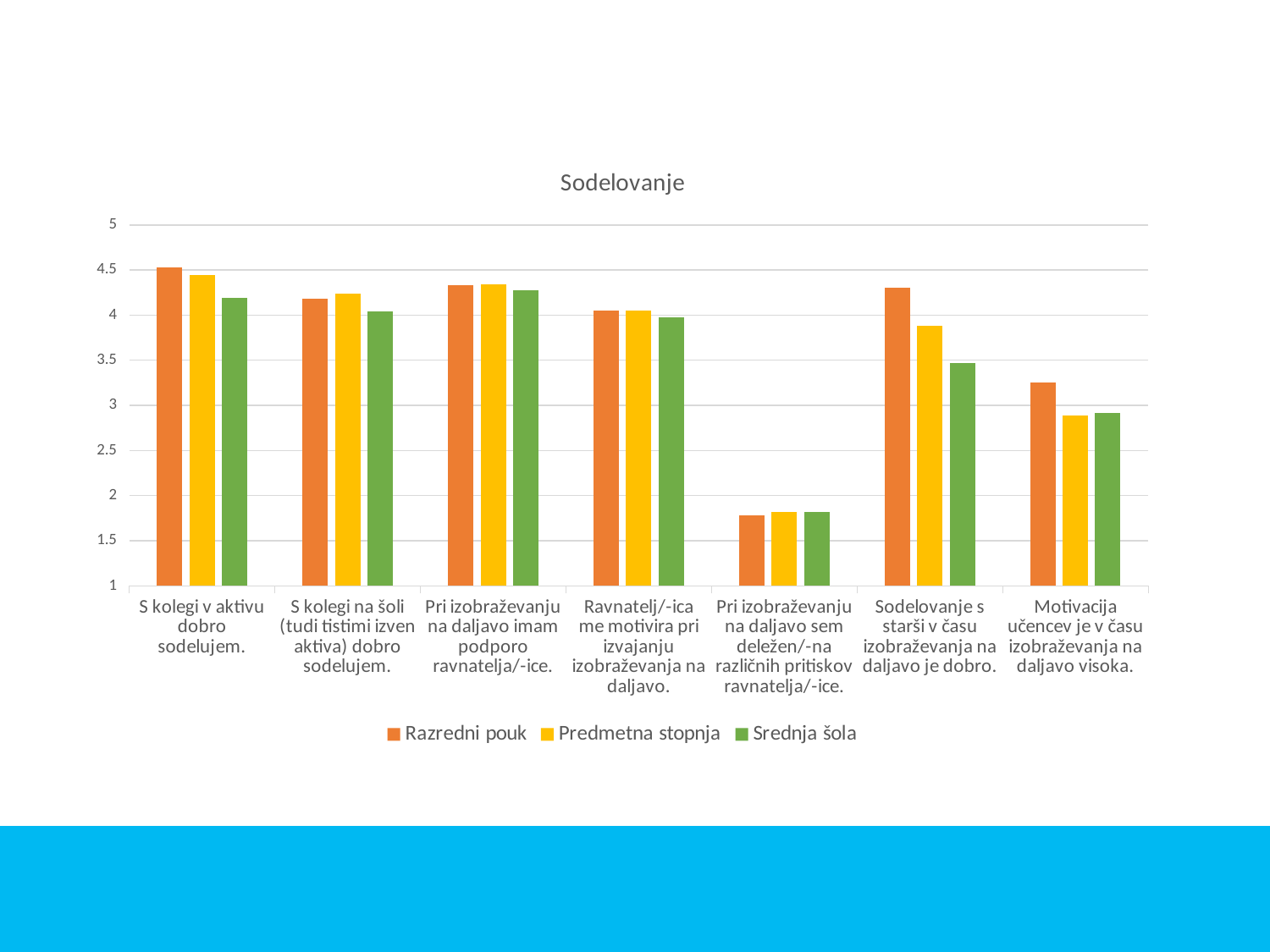
What kind of chart is shown on the slide? bar chart Is the Razredni pouk value for 'Motivacija učencev je v času izobraževanja na daljavo visoka.' greater or less than 3? greater For 'Sodelovanje s starši v času izobraževanja na daljavo je dobro.', which series has the larger value: Razredni pouk or Srednja šola? Razredni pouk Is the Predmetna stopnja value for 'Pri izobraževanju na daljavo sem deležen/-na različnih pritiskov ravnatelja/-ice.' greater or less than 2? less Which series has the lowest value for 'Sodelovanje s starši v času izobraževanja na daljavo je dobro.'? Srednja šola For 'Motivacija učencev je v času izobraževanja na daljavo visoka.', which series has the larger value: Razredni pouk or Predmetna stopnja? Razredni pouk Which category has the lowest value for Razredni pouk? Pri izobraževanju na daljavo sem deležen/-na različnih pritiskov ravnatelja/-ice. How many series does the legend list? 3 How many categories are shown on the x axis? 7 What is the title of the chart? Sodelovanje Is the Srednja šola value for 'Sodelovanje s starši v času izobraževanja na daljavo je dobro.' greater or less than 4? less Which category has the highest value for Razredni pouk? S kolegi v aktivu dobro sodelujem.